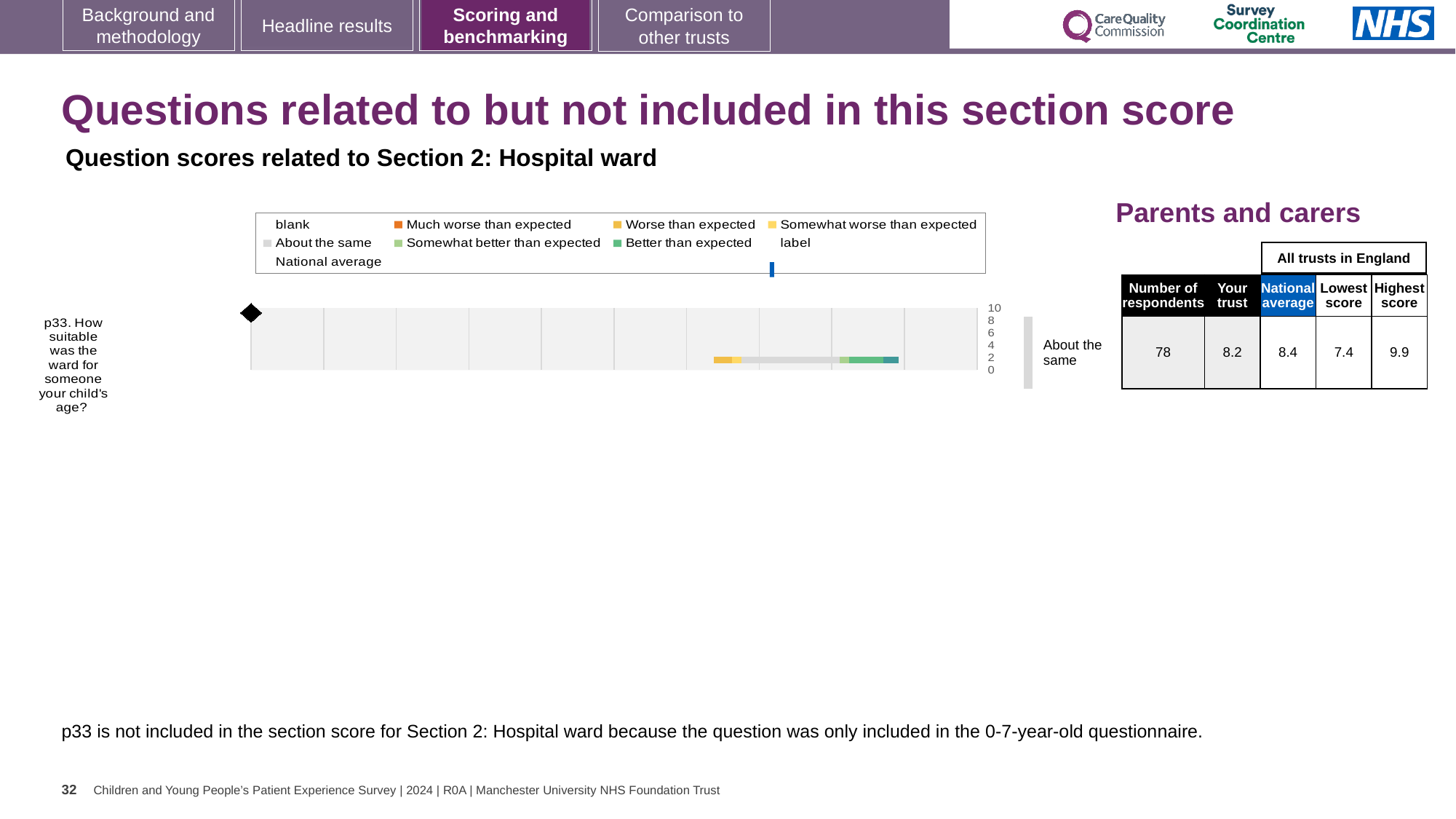
What is the difference between the highest and lowest trust scores for p33? 2.5 By how much does the national average exceed the 'Your trust' score for p33? 0.2 How many survey questions are plotted in the chart? 1 What is the 'Your trust' score for p33 in the table? 8.2 What benchmark category label is shown to the right of the bar for p33? About the same What is the national average score for p33? 8.4 Which question is plotted in the chart? p33. How suitable was the ward for someone your child's age? What kind of chart is shown for question p33? bar chart What is the highest score among all trusts in England for p33? 9.9 Which is larger for p33: the 'Your trust' score or the national average? National average How many respondents answered p33? 78 What is the lowest score among all trusts in England for p33? 7.4